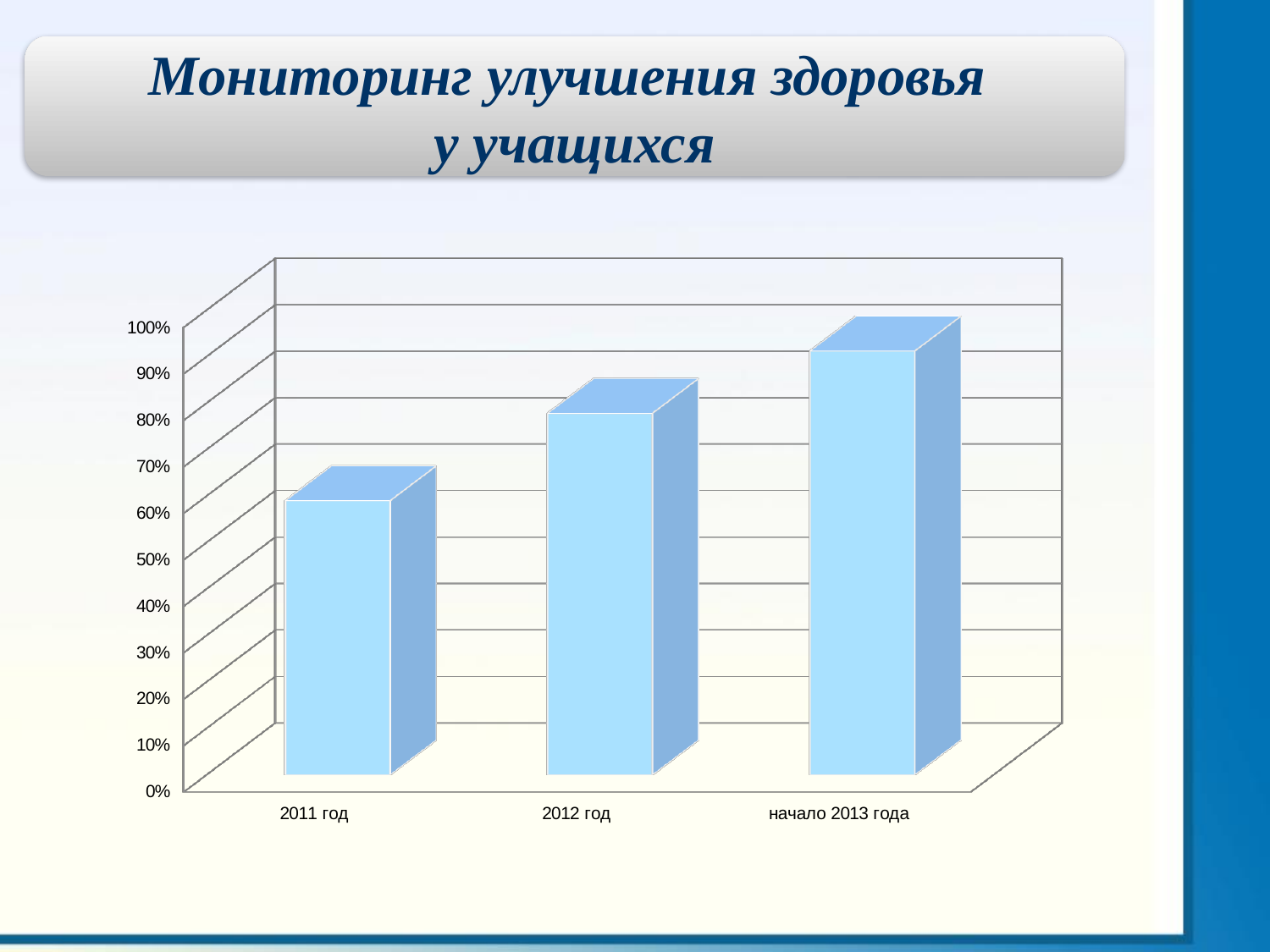
What kind of chart is shown on the slide? bar chart Is the value for 2012 год greater or less than 70%? greater What is the highest value shown on the vertical axis of the chart? 100% Which is larger, the value for 2011 год or the value for 2012 год? 2012 год Do the values rise or fall from 2011 год to начало 2013 года? rise What is the title of the slide containing the chart? Мониторинг улучшения здоровья у учащихся Which category has the highest bar? начало 2013 года Which category has the lowest bar? 2011 год How many categories are shown on the x axis of the chart? 3 Which is larger, the value for 2012 год or the value for начало 2013 года? начало 2013 года Is the value for 2011 год greater or less than 70%? less Is the value for начало 2013 года greater or less than 80%? greater